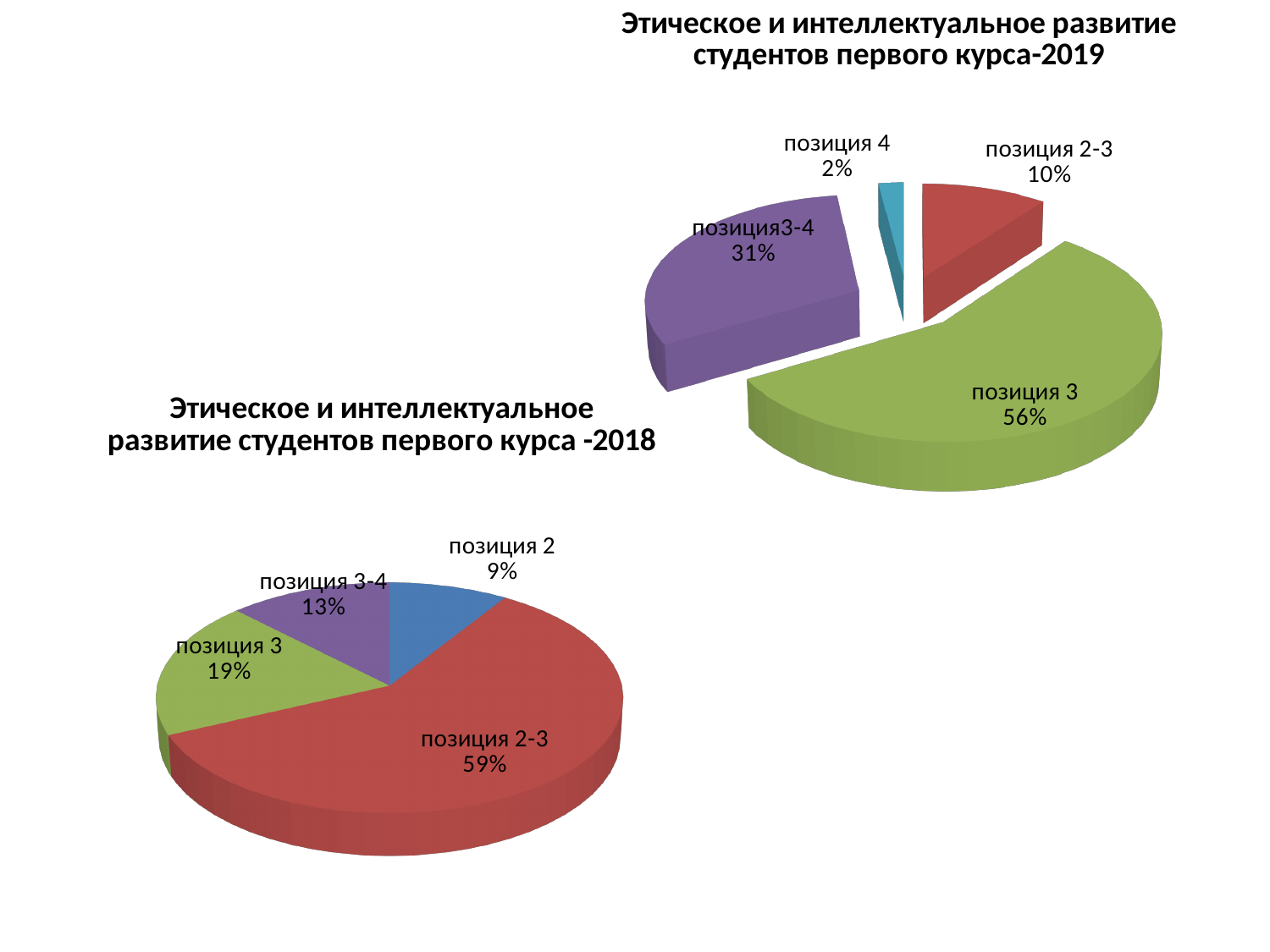
In the 2018 chart (bottom left), which is larger: позиция 3 or позиция 3-4? позиция 3 How many slices does the 2019 chart (top right) have? 4 In the 2019 chart (top right), what share does позиция 3 have? 56% In the 2018 chart (bottom left), what share does позиция 2-3 have? 59% In the 2019 chart (top right), what is the difference between позиция3-4 and позиция 2-3? 21% In the 2018 chart (bottom left), what share does позиция 3-4 have? 13% In the 2018 chart (bottom left), which category has the smallest slice? позиция 2 In the 2019 chart (top right), which category has the smallest slice? позиция 4 In the 2019 chart (top right), what share does позиция 4 have? 2% In the 2019 chart (top right), which category has the largest slice? позиция 3 What type of chart is the 2018 chart (bottom left)? Pie chart In the 2018 chart (bottom left), what is the difference between позиция 2-3 and позиция 3? 40%